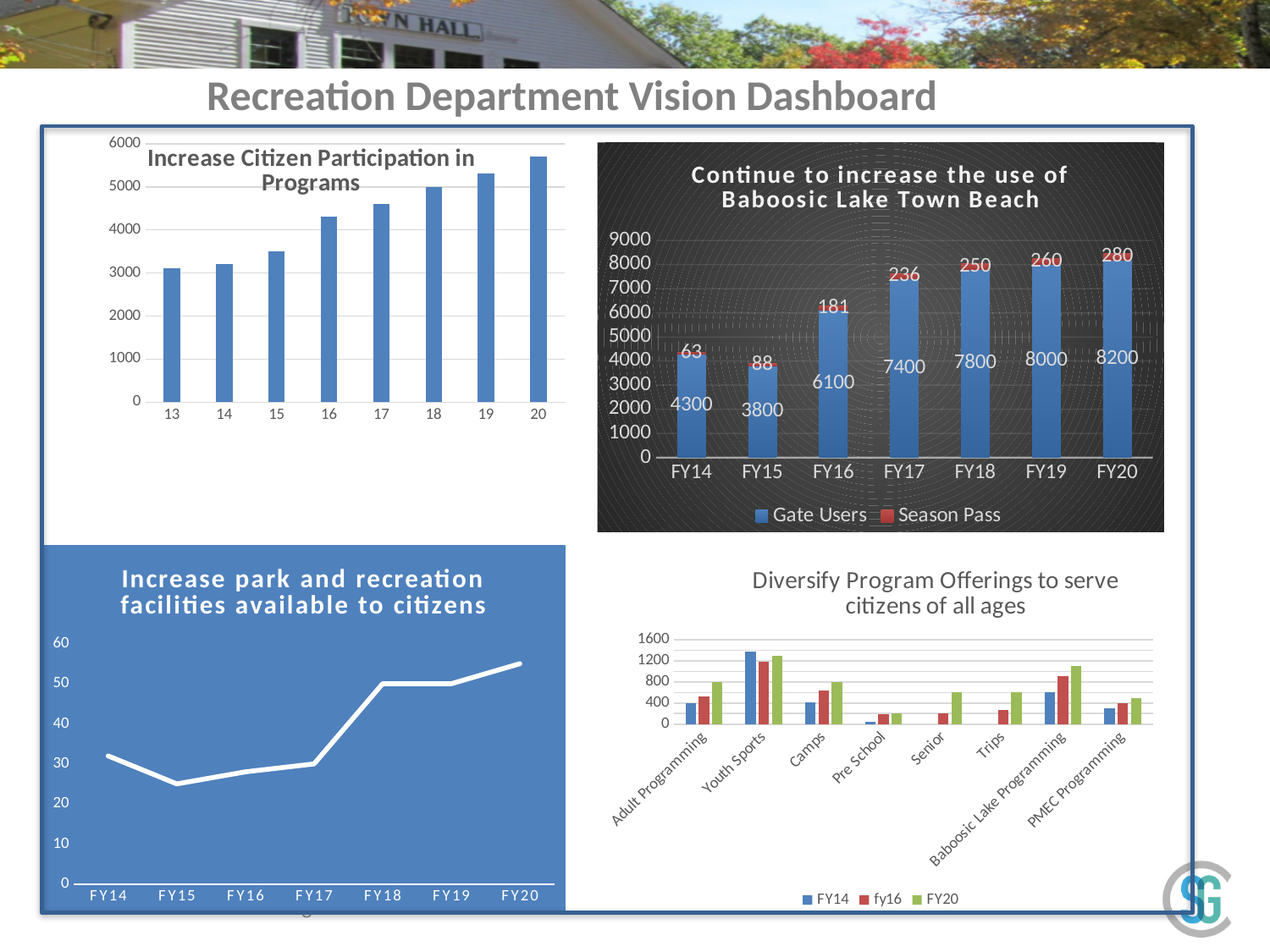
In the 'Increase park and recreation facilities available to citizens' chart, is the value for FY15 greater or less than 30? less In the 'Increase Citizen Participation in Programs' chart, is the value for 16 greater or less than 4000? greater In the 'Continue to increase the use of Baboosic Lake Town Beach' chart, what is the difference in Gate Users between FY20 and FY19? 200 In the 'Diversify Program Offerings to serve citizens of all ages' chart, which category has the highest bars? Youth Sports In the 'Continue to increase the use of Baboosic Lake Town Beach' chart, which fiscal year has the lowest Gate Users value? FY15 In the 'Continue to increase the use of Baboosic Lake Town Beach' chart, what is the Season Pass value for FY16? 181 How many series does the legend of the 'Continue to increase the use of Baboosic Lake Town Beach' chart list? 2 In the 'Increase Citizen Participation in Programs' chart, how many bars are plotted? 8 In the 'Increase Citizen Participation in Programs' chart, do the values generally rise or fall from 13 to 20? rise In the 'Continue to increase the use of Baboosic Lake Town Beach' chart, what is the total of the FY20 stacked bar (Gate Users plus Season Pass)? 8480 In the 'Continue to increase the use of Baboosic Lake Town Beach' chart, what is the Gate Users value for FY17? 7400 What kind of chart is the 'Increase park and recreation facilities available to citizens' chart? line chart